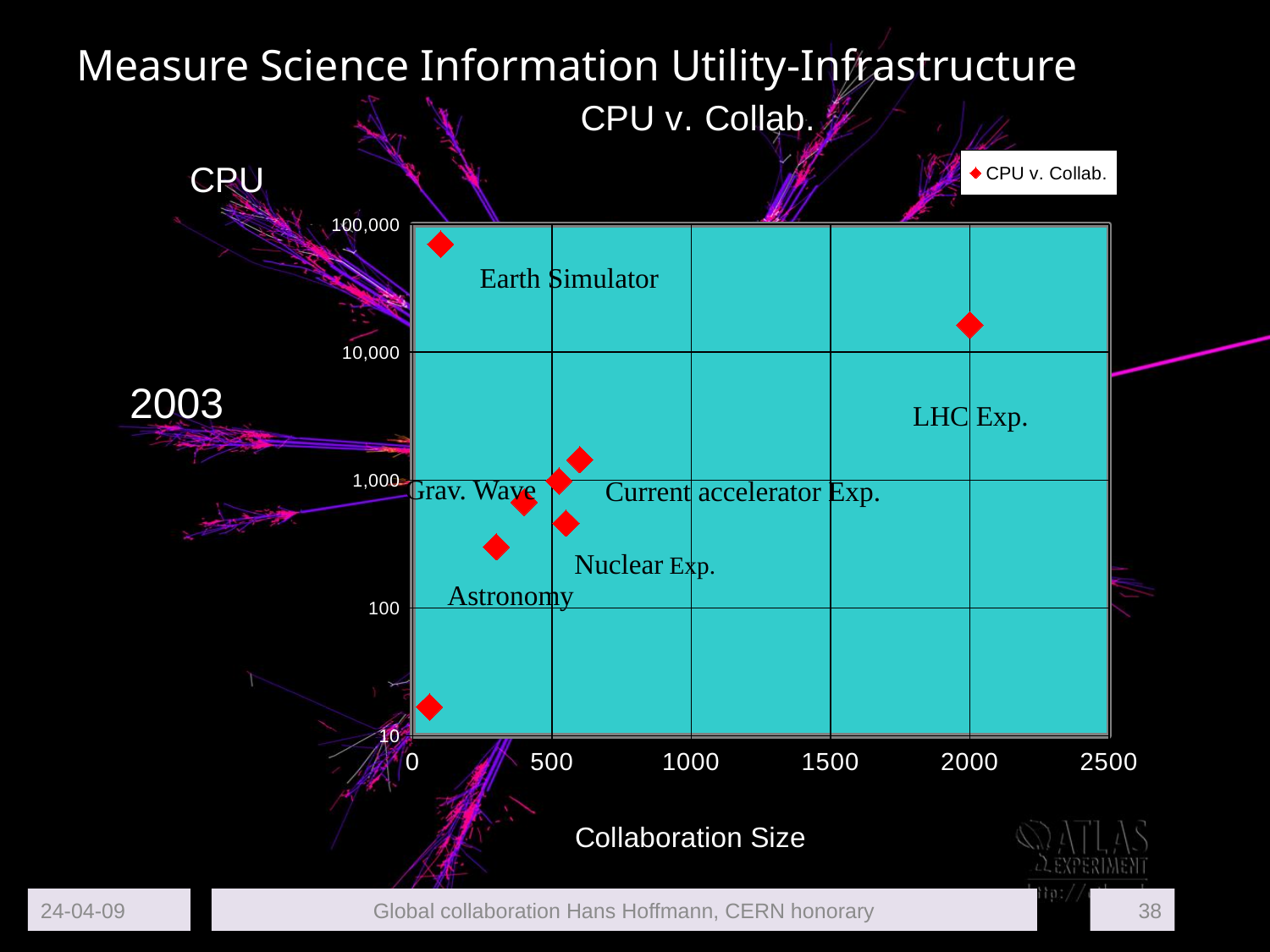
Is the collaboration size for Earth Simulator greater or less than 500? less Is the CPU value for Earth Simulator greater or less than 10,000? greater How many data points are plotted on the chart? 8 What is the title of the chart? CPU v. Collab. Which labeled point has the highest CPU value? Earth Simulator Which has the higher CPU value, LHC Exp. or Earth Simulator? Earth Simulator What is the label of the x axis? Collaboration Size Which labeled point has the largest collaboration size? LHC Exp. What kind of chart is shown on the slide? scatter chart How many series does the legend list? 1 Is the collaboration size for LHC Exp. greater or less than 1500? greater